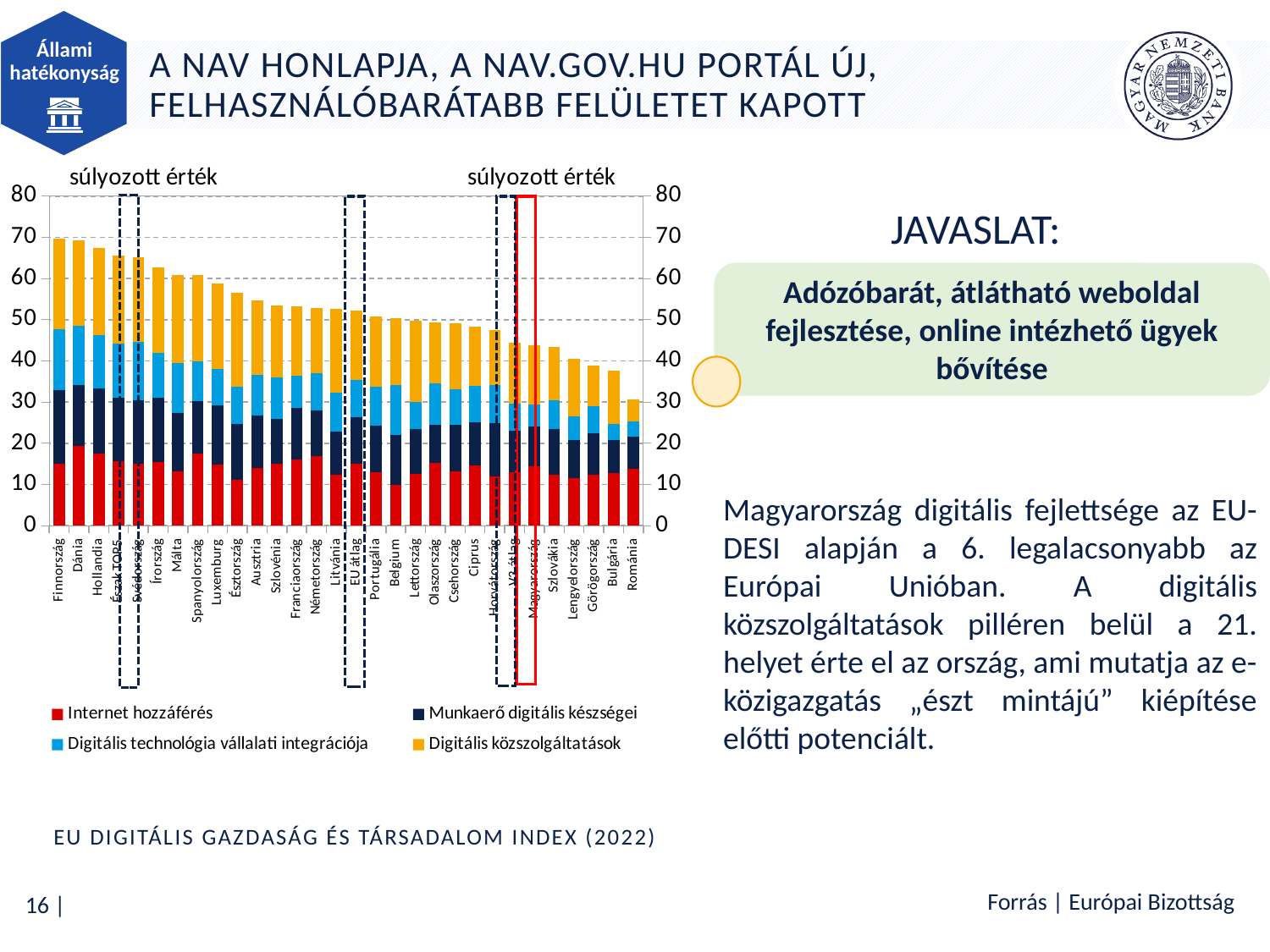
What kind of chart is shown on the slide? Stacked bar chart Which has the larger total bar, Dánia or Magyarország? Dánia Is the total value for Románia greater or less than 40? less What is the title of the chart shown below it on the slide? EU DIGITÁLIS GAZDASÁG ÉS TÁRSADALOM INDEX (2022) Which category has the lowest total bar in the chart? Románia Is the total value for Finnország greater or less than 60? greater Which category has the highest total bar in the chart? Finnország Which series is shown in yellow/orange at the top of each stacked bar? Digitális közszolgáltatások Do the total bar heights rise or fall moving from left to right along the x axis? Fall Is the total value for Magyarország greater or less than 50? less How many series does the chart legend list? 4 How many categories (bars) are shown along the x axis of the chart? 30